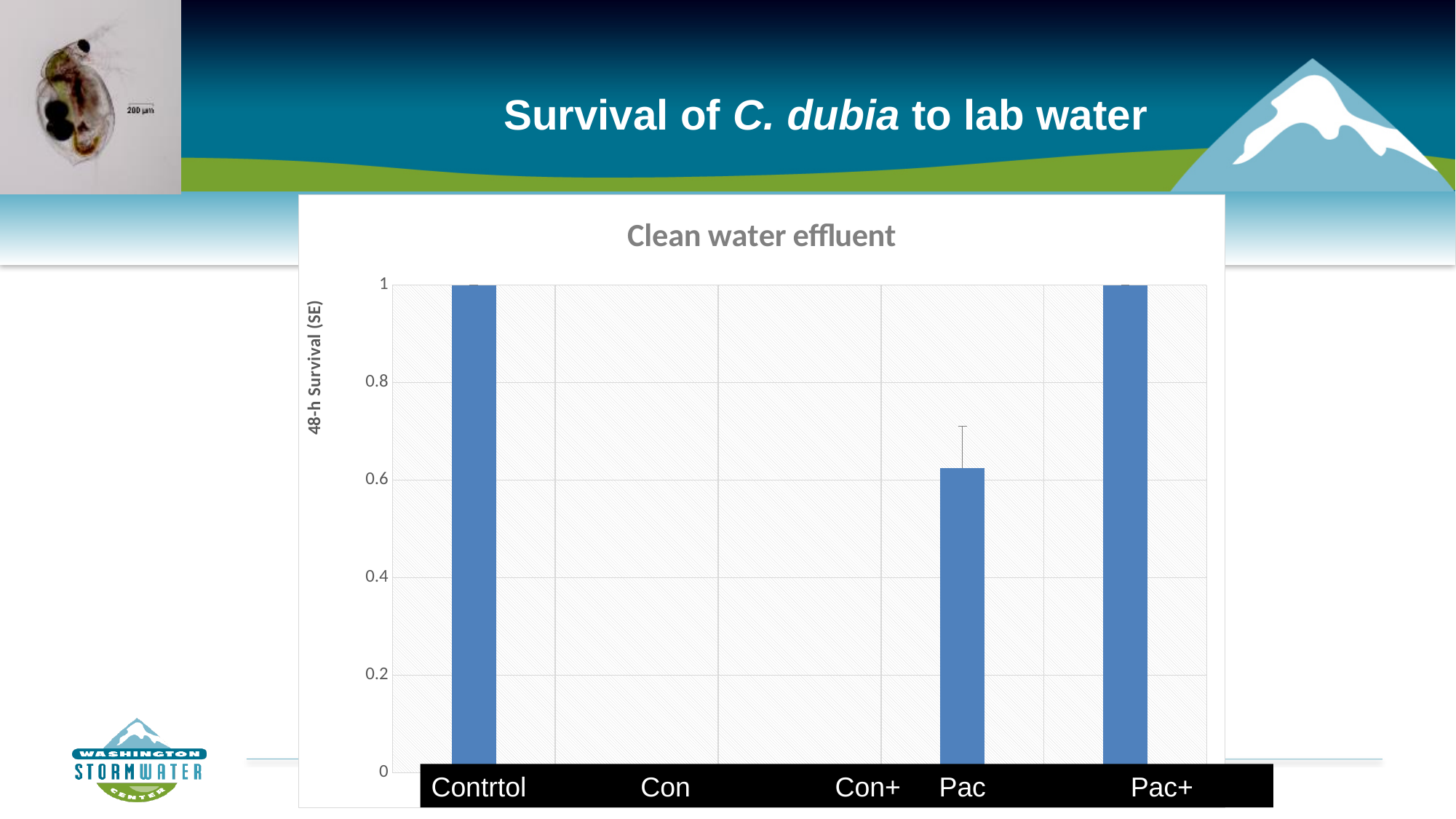
What is the label of the vertical axis? 48-h Survival (SE) How many categories are shown on the x axis? 5 What type of chart is shown on the slide? bar chart What is the 48-h survival value for Pac+? 1 Is the value for Pac greater or less than 0.8? less Which has the larger value, Pac or Pac+? Pac+ Is the value for Pac greater or less than 0.4? greater Is the value for Contrtol greater or less than 0.8? greater What is the 48-h survival value for Contrtol? 1 What is the title of the chart? Clean water effluent Which has the larger value, Contrtol or Pac? Contrtol